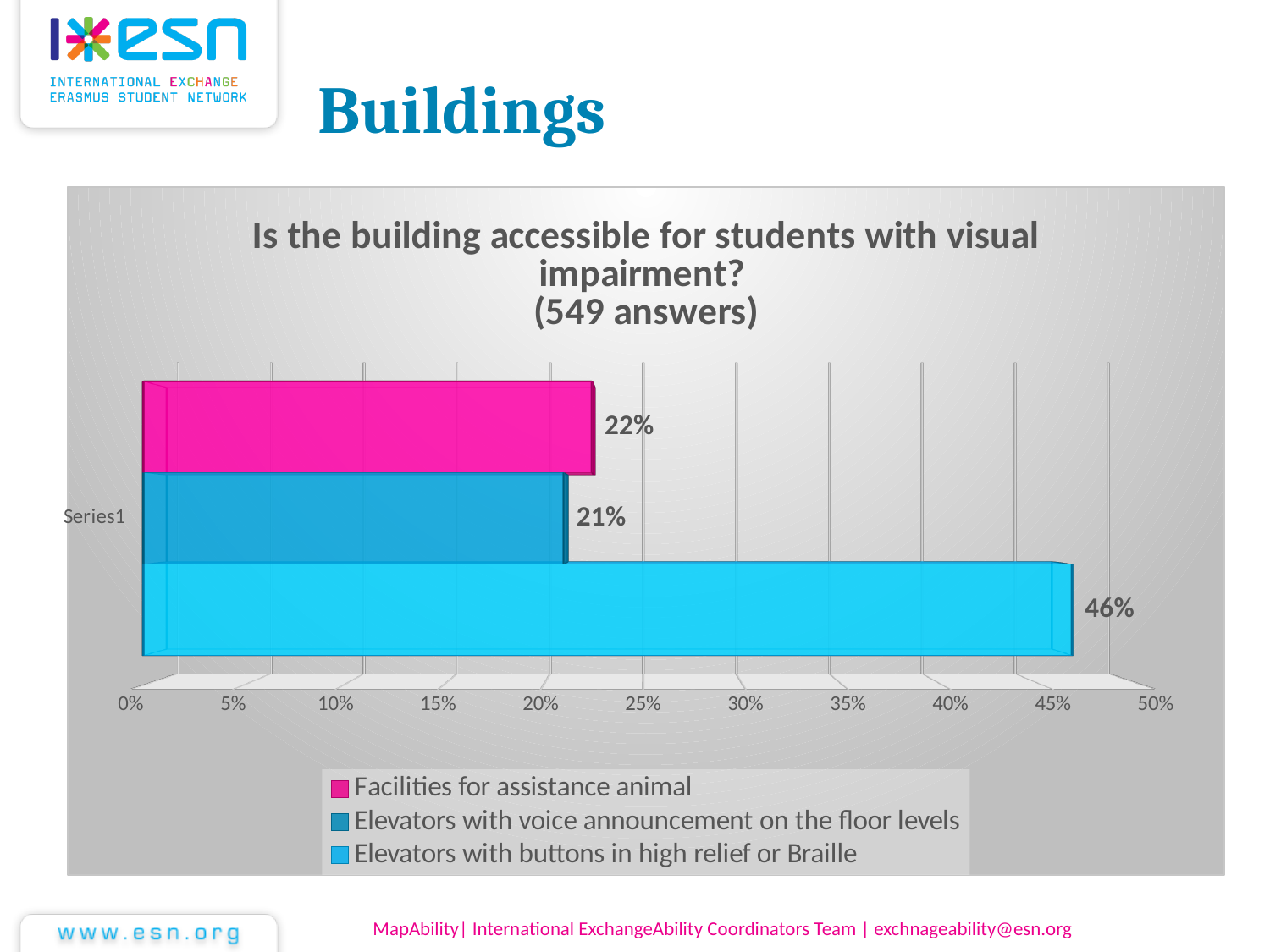
What percentage is shown for 'Facilities for assistance animal'? 22% Which option has the highest percentage? Elevators with buttons in high relief or Braille What is the difference between the percentage for 'Facilities for assistance animal' and 'Elevators with voice announcement on the floor levels'? 1% What is the difference between the percentage for 'Elevators with buttons in high relief or Braille' and 'Facilities for assistance animal'? 24% What percentage is shown for 'Elevators with buttons in high relief or Braille'? 46% What percentage is shown for 'Elevators with voice announcement on the floor levels'? 21% Which is larger: the value for 'Elevators with buttons in high relief or Braille' or the value for 'Facilities for assistance animal'? Elevators with buttons in high relief or Braille Which option has the lowest percentage? Elevators with voice announcement on the floor levels What kind of chart is shown on the slide? Bar chart How many entries does the legend list? 3 How many answers does the chart title say were collected? 549 Is the value for 'Elevators with buttons in high relief or Braille' greater or less than 40%? greater